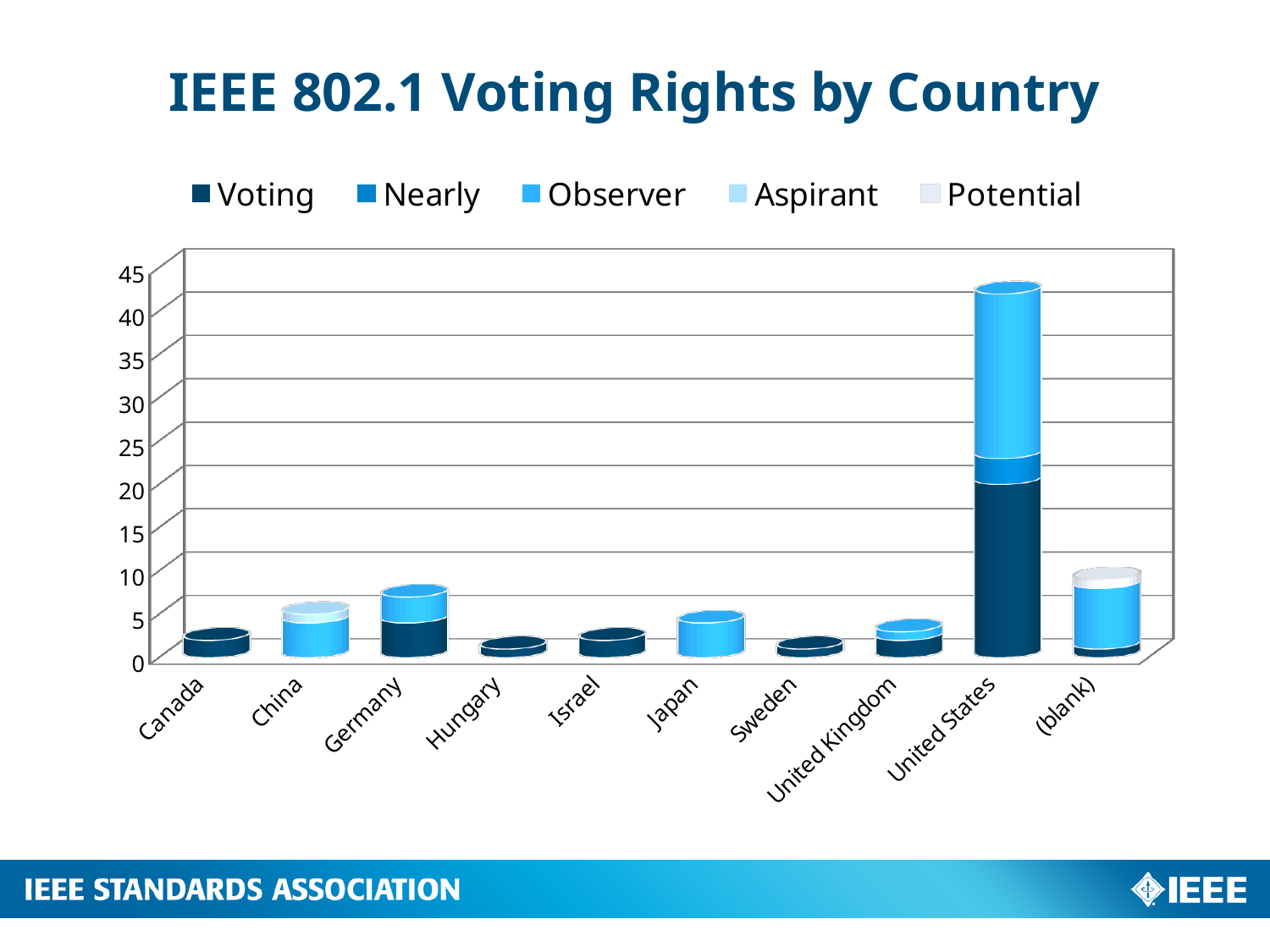
Is the total value for Canada greater or less than 5? less How many countries (categories) are shown on the x axis? 10 Is the total value for United States greater or less than 35? greater How many series does the legend list? 5 What is the title of the chart? IEEE 802.1 Voting Rights by Country Is the total value for Germany greater or less than 10? less What type of chart is shown on the slide? bar chart Which has the taller stacked bar, United States or Germany? United States Which series is listed first in the legend? Voting Which has the taller stacked bar, Germany or Canada? Germany Which category has the tallest stacked bar? United States